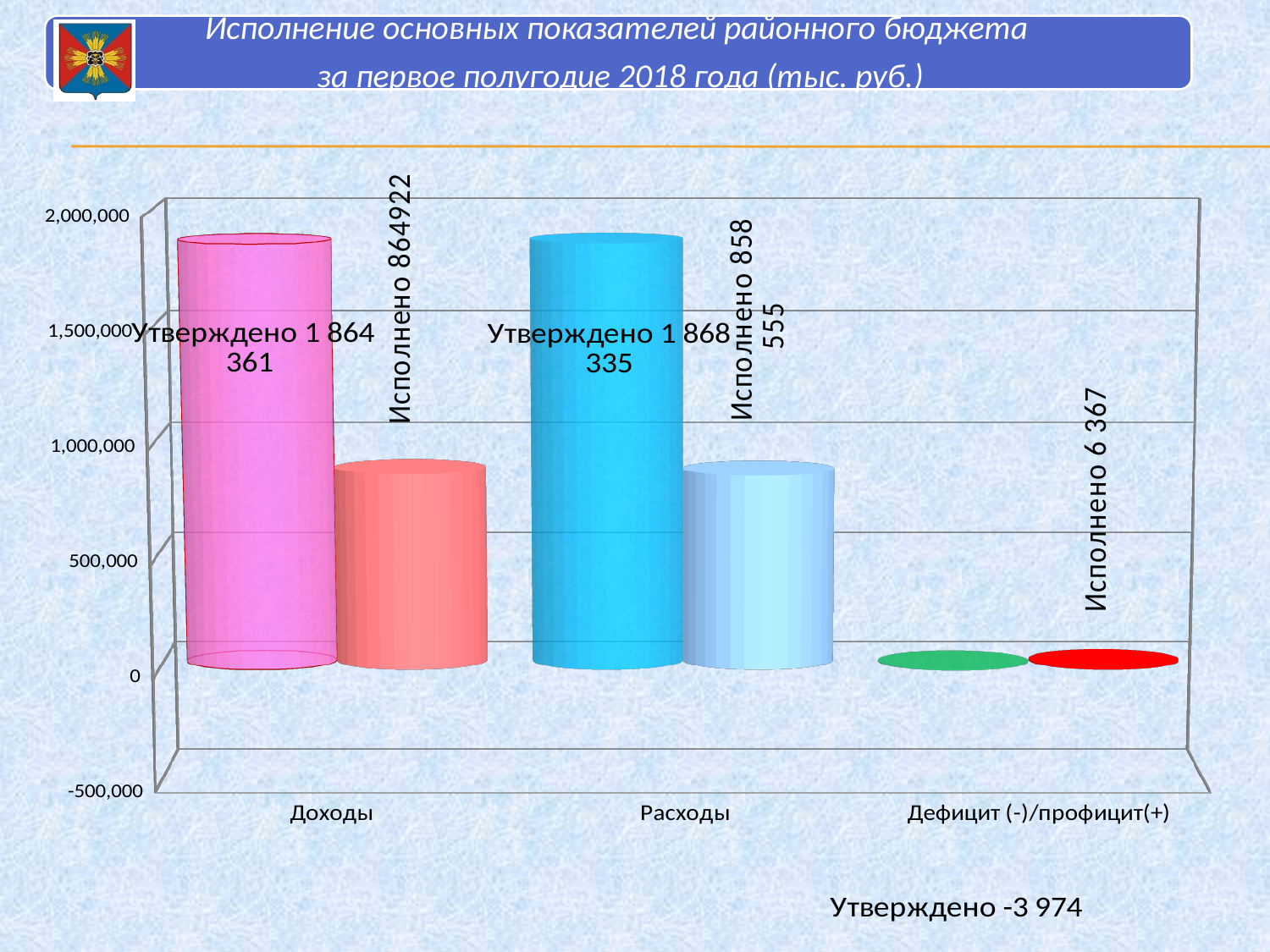
Which category has the lowest executed (Исполнено) value? Дефицит (-)/профицит(+) What is the approved (Утверждено) value for Дефицит (-)/профицит(+)? -3 974 What is the executed (Исполнено) value for Доходы? 864922 What is the executed (Исполнено) value for Расходы? 858 555 What kind of chart is shown on the slide? Bar chart How many categories are shown on the x axis? 3 Is the approved (Утверждено) value for Расходы greater or less than 1,500,000? greater What is the executed (Исполнено) value for Дефицит (-)/профицит(+)? 6 367 What is the approved (Утверждено) value for Доходы? 1 864 361 Is the executed (Исполнено) value for Доходы greater or less than 1,000,000? less What is the difference between the approved and executed values for Расходы? 1 009 780 What is the approved (Утверждено) value for Расходы? 1 868 335